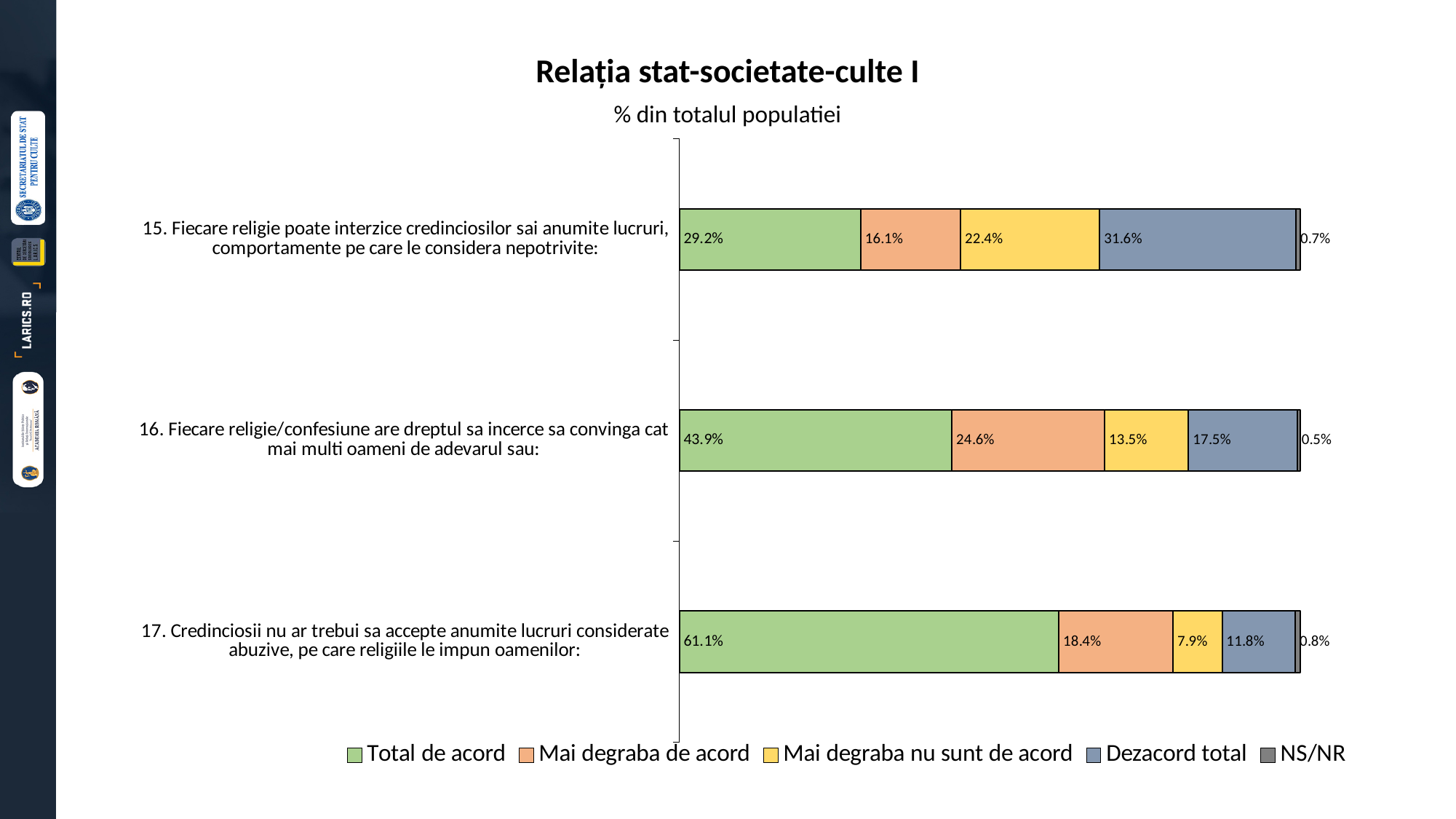
What is the 'Total de acord' value for statement 15? 29.2% What is the NS/NR value for statement 15? 0.7% How many series does the legend list? 5 How many statements (categories) are plotted in the chart? 3 Which statement has the lowest NS/NR value? 16. Fiecare religie/confesiune are dreptul sa incerce sa convinga cat mai multi oameni de adevarul sau Which is larger: the 'Mai degraba de acord' value for statement 16 or for statement 17? Statement 16 (24.6%) Which statement has the highest 'Total de acord' value? 17. Credinciosii nu ar trebui sa accepte anumite lucruri considerate abuzive, pe care religiile le impun oamenilor What is the subtitle shown above the chart? % din totalul populatiei What type of chart is shown on the slide? Stacked bar chart What is the 'Dezacord total' value for statement 16? 17.5% What is the difference between the 'Total de acord' values for statement 17 and statement 15? 31.9 percentage points What is the 'Mai degraba nu sunt de acord' value for statement 17? 7.9%